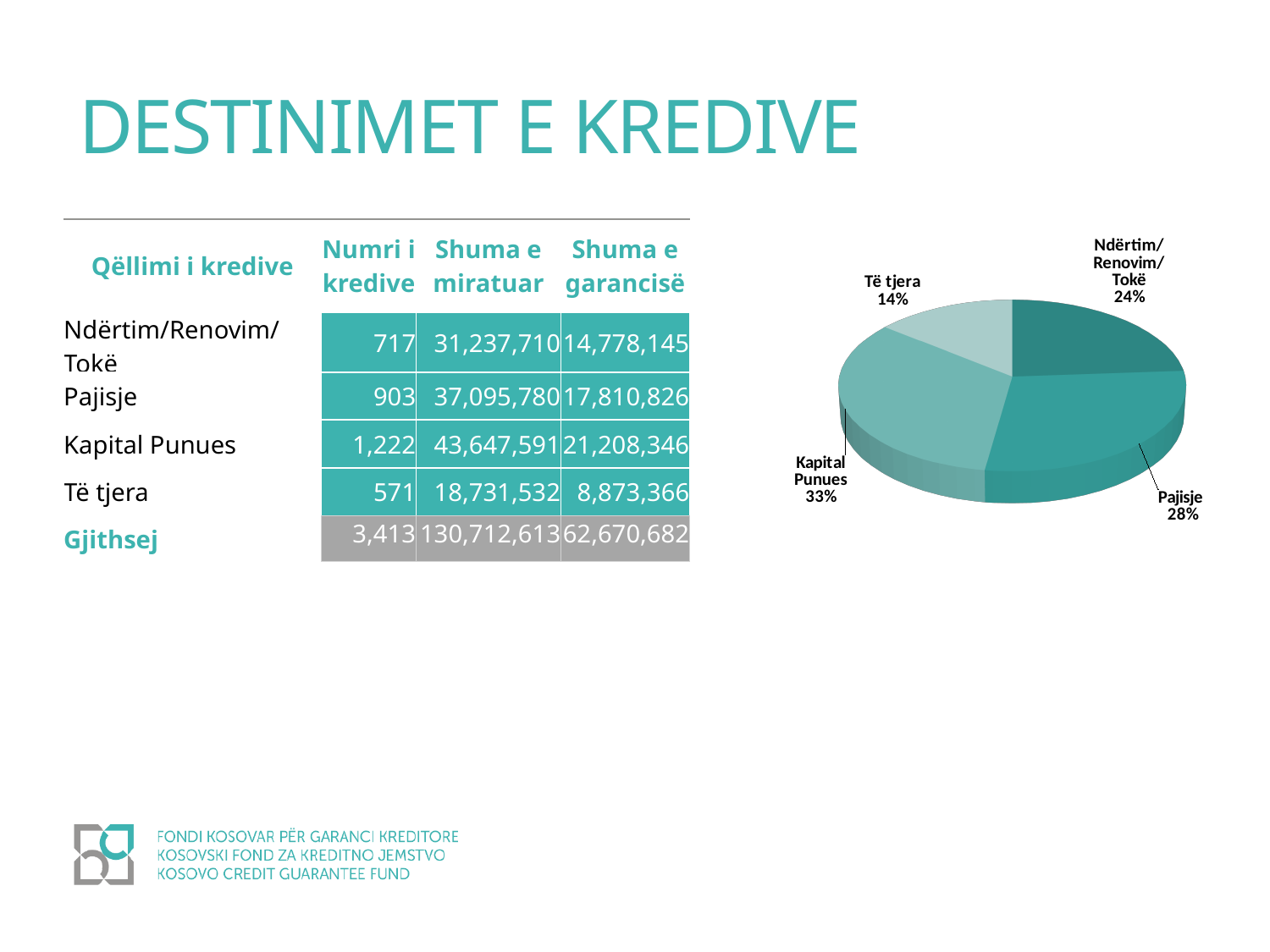
Which slice of the pie chart is the largest? Kapital Punues How many slices does the pie chart have? 4 What share of the pie does Të tjera represent? 14% What kind of chart is shown on the slide? pie chart What share of the pie does Pajisje represent? 28% What is the difference in percentage points between the Pajisje slice and the Ndërtim/Renovim/Tokë slice? 4 What is the difference in percentage points between the Kapital Punues slice and the Të tjera slice? 19 Which slice of the pie chart is the smallest? Të tjera Is the share for Kapital Punues greater or less than 30%? greater What share of the pie does Kapital Punues represent? 33% Which is larger in the pie chart, Pajisje or Ndërtim/Renovim/Tokë? Pajisje